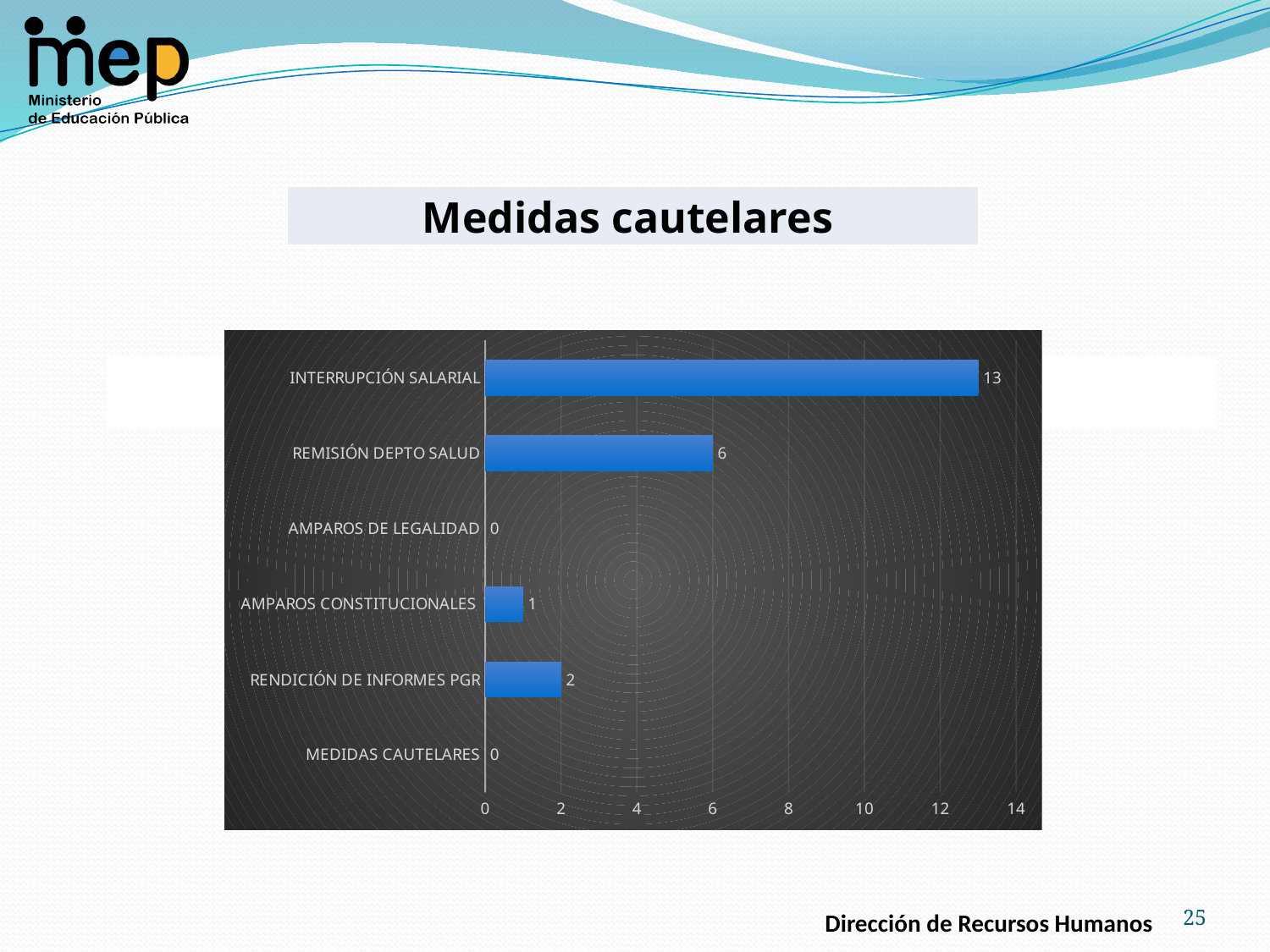
Which category has the highest value? INTERRUPCIÓN SALARIAL What is the value for AMPAROS DE LEGALIDAD? 0 What is the title of the slide above the chart? Medidas cautelares What is the value for REMISIÓN DEPTO SALUD? 6 Is the value for INTERRUPCIÓN SALARIAL greater or less than 10? greater What is the value for INTERRUPCIÓN SALARIAL? 13 What is the value for RENDICIÓN DE INFORMES PGR? 2 What kind of chart is shown on the slide? bar chart What is the value for AMPAROS CONSTITUCIONALES? 1 How many categories are shown in the chart? 6 Which is larger, the value for RENDICIÓN DE INFORMES PGR or the value for AMPAROS CONSTITUCIONALES? RENDICIÓN DE INFORMES PGR What is the difference between the values for INTERRUPCIÓN SALARIAL and REMISIÓN DEPTO SALUD? 7